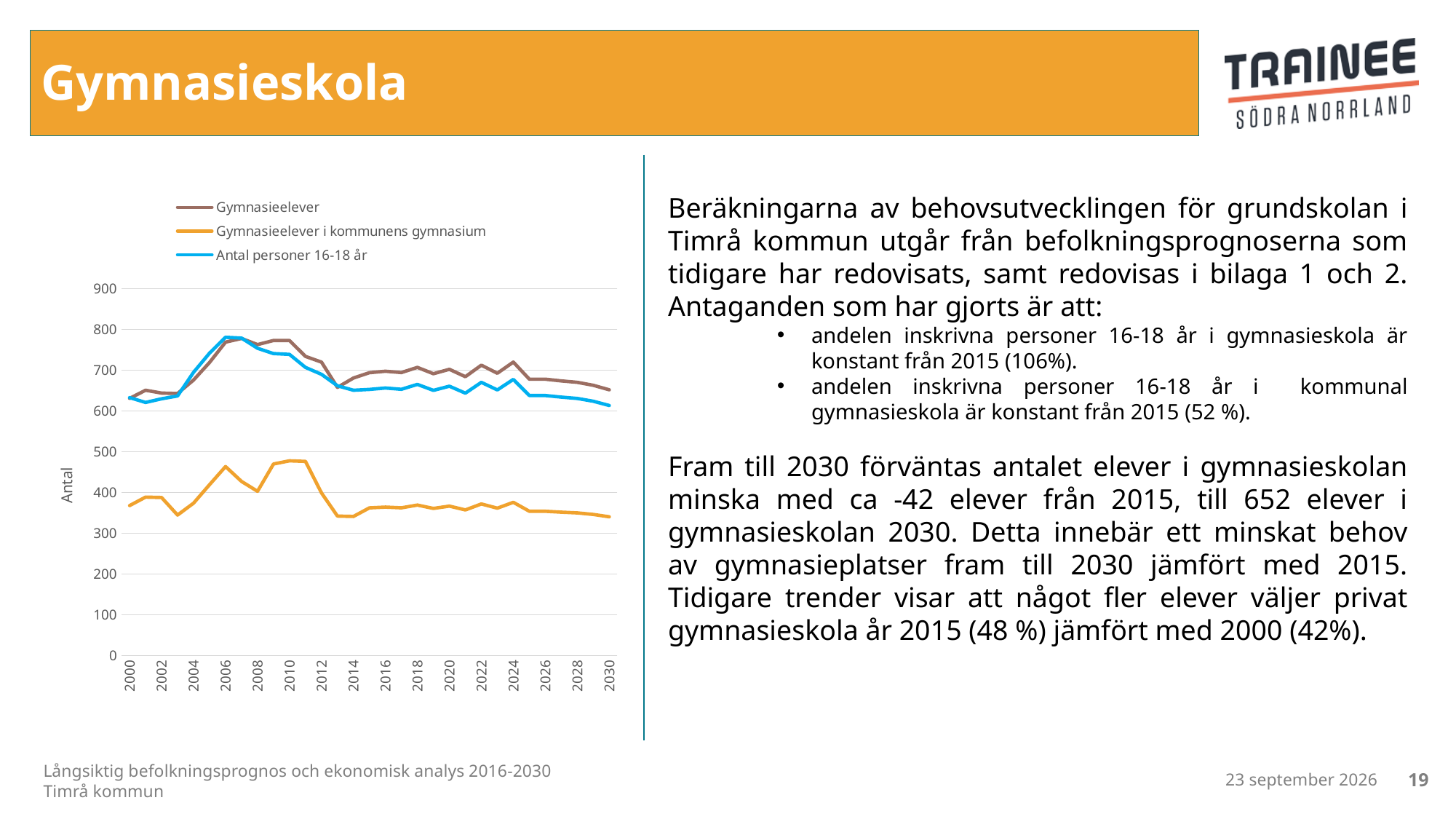
Is the value for Gymnasieelever i kommunens gymnasium in 2014 greater or less than 400? less Is the value for Antal personer 16-18 år in 2006 greater or less than 700? greater Is the value for Gymnasieelever i kommunens gymnasium in 2030 greater or less than 400? less Does the Gymnasieelever i kommunens gymnasium line rise or fall between 2024 and 2030? Fall Does the Antal personer 16-18 år line rise or fall between 2000 and 2006? Rise How many series does the chart legend list? 3 What kind of chart is shown on the slide? Line chart In 2030, which is higher: Gymnasieelever or Antal personer 16-18 år? Gymnasieelever Which series in the chart is drawn in orange? Gymnasieelever i kommunens gymnasium What is the label on the vertical axis of the chart? Antal Which series has the lowest values across the whole period? Gymnasieelever i kommunens gymnasium